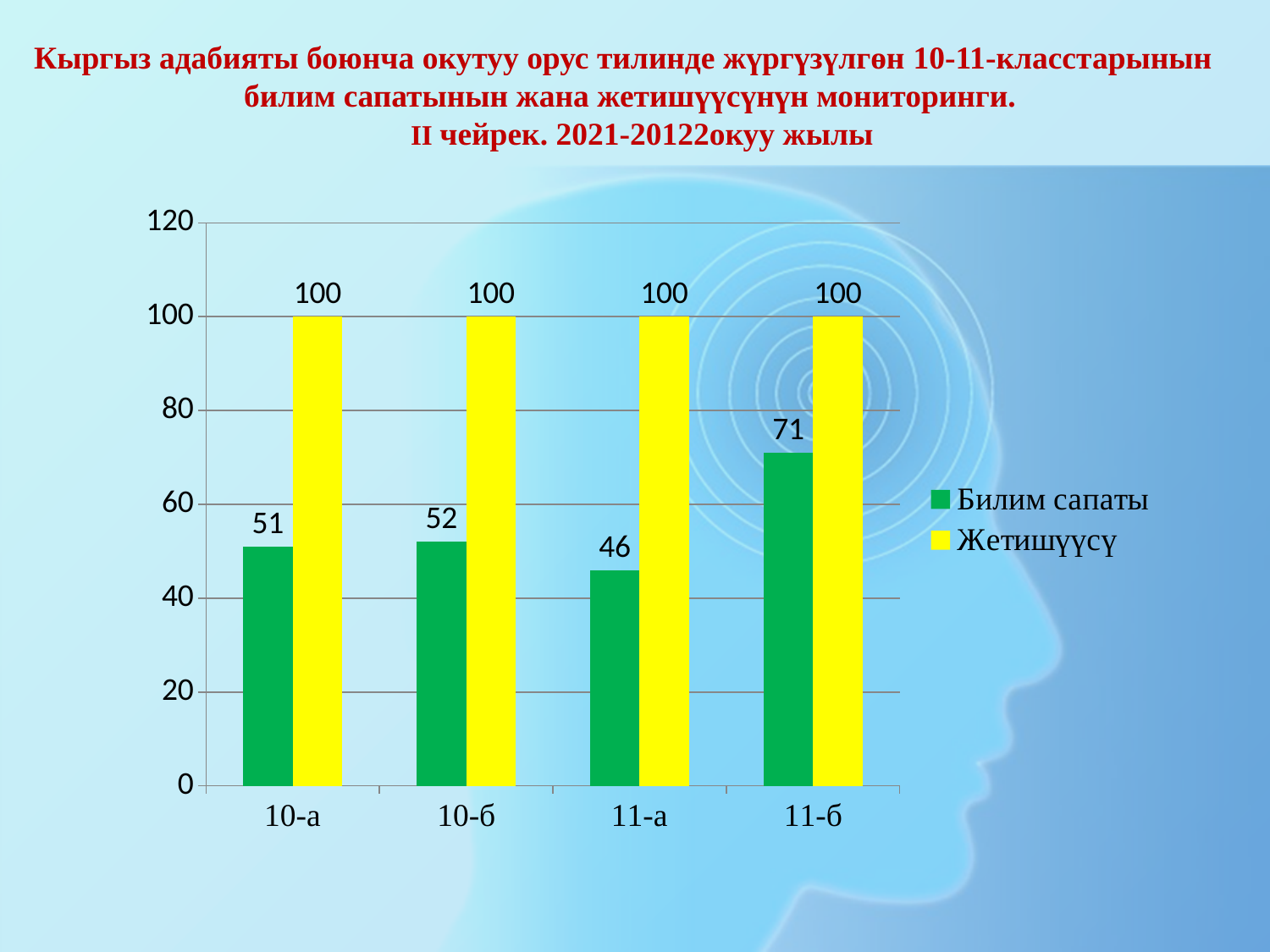
What colour are the Жетишүүсү bars? yellow How many series does the legend list? 2 Which is larger, the Билим сапаты value for 10-а or for 10-б? 10-б What kind of chart is shown on the slide? bar chart What is the value of Жетишүүсү for 11-а? 100 What is the value of Билим сапаты for 11-б? 71 What is the difference between the Билим сапаты values for 11-б and 11-а? 25 How many classes are shown on the x axis? 4 Which class has the lowest Билим сапаты value? 11-а Is the Билим сапаты value for 11-б greater or less than 60? greater What is the value of Билим сапаты for 10-а? 51 Which class has the highest Билим сапаты value? 11-б